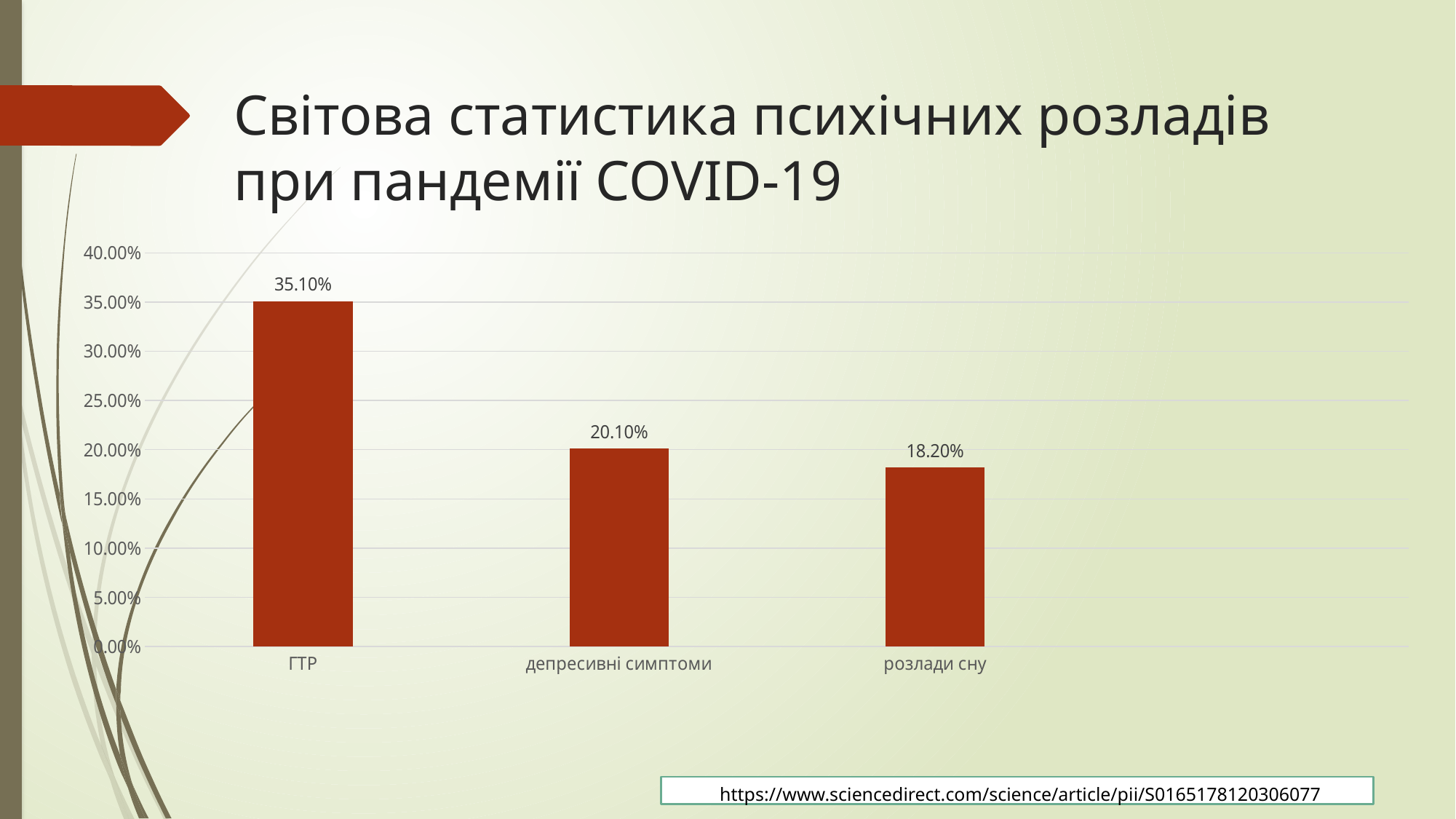
Which category has the highest value? ГТР What is the value for ГТР? 35.10% How many categories are shown in the chart? 3 Which category has the lowest value? розлади сну What kind of chart is shown on the slide? bar chart Which is larger, the value for ГТР or the value for розлади сну? ГТР Do the values rise or fall from left to right across the categories? fall What is the value for розлади сну? 18.20% Is the value for ГТР greater or less than 30.00%? greater What is the value for депресивні симптоми? 20.10% What is the difference between the values for ГТР and депресивні симптоми? 15.00% What is the difference between the values for депресивні симптоми and розлади сну? 1.90%